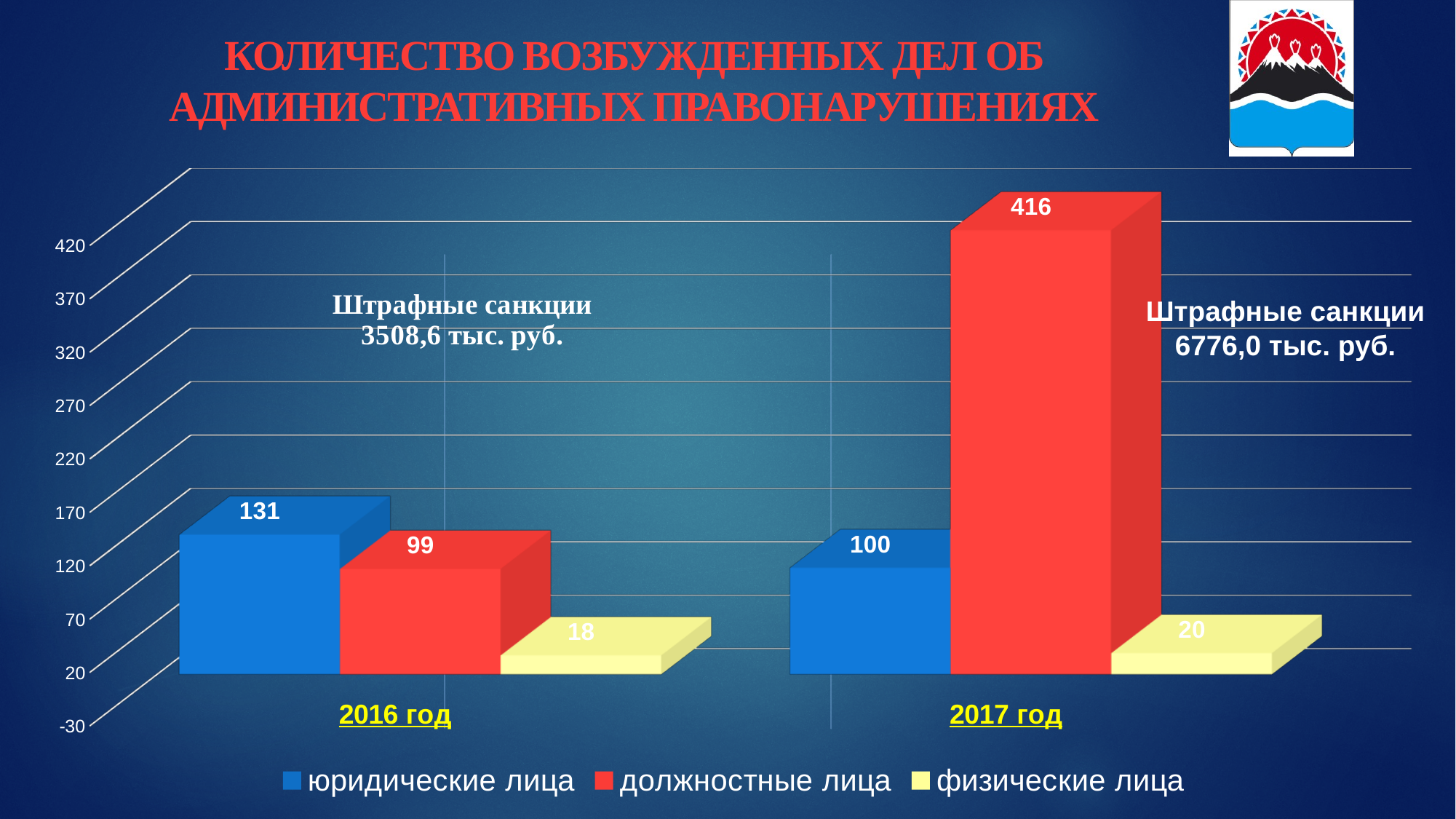
Which series has the highest value in 2017 год? должностные лица What is the value for должностные лица in 2017 год? 416 What is the difference between должностные лица in 2017 год and in 2016 год? 317 What kind of chart is shown on the slide? bar chart What is the value for физические лица in 2016 год? 18 How many year categories are shown on the x axis? 2 What is the value for юридические лица in 2017 год? 100 What is the value for юридические лица in 2016 год? 131 Which series has the lowest value in 2016 год? физические лица Which is larger: юридические лица in 2016 год or юридические лица in 2017 год? 2016 год What amount of fines (Штрафные санкции) is shown for 2017 год? 6776,0 тыс. руб. How many series does the legend list? 3